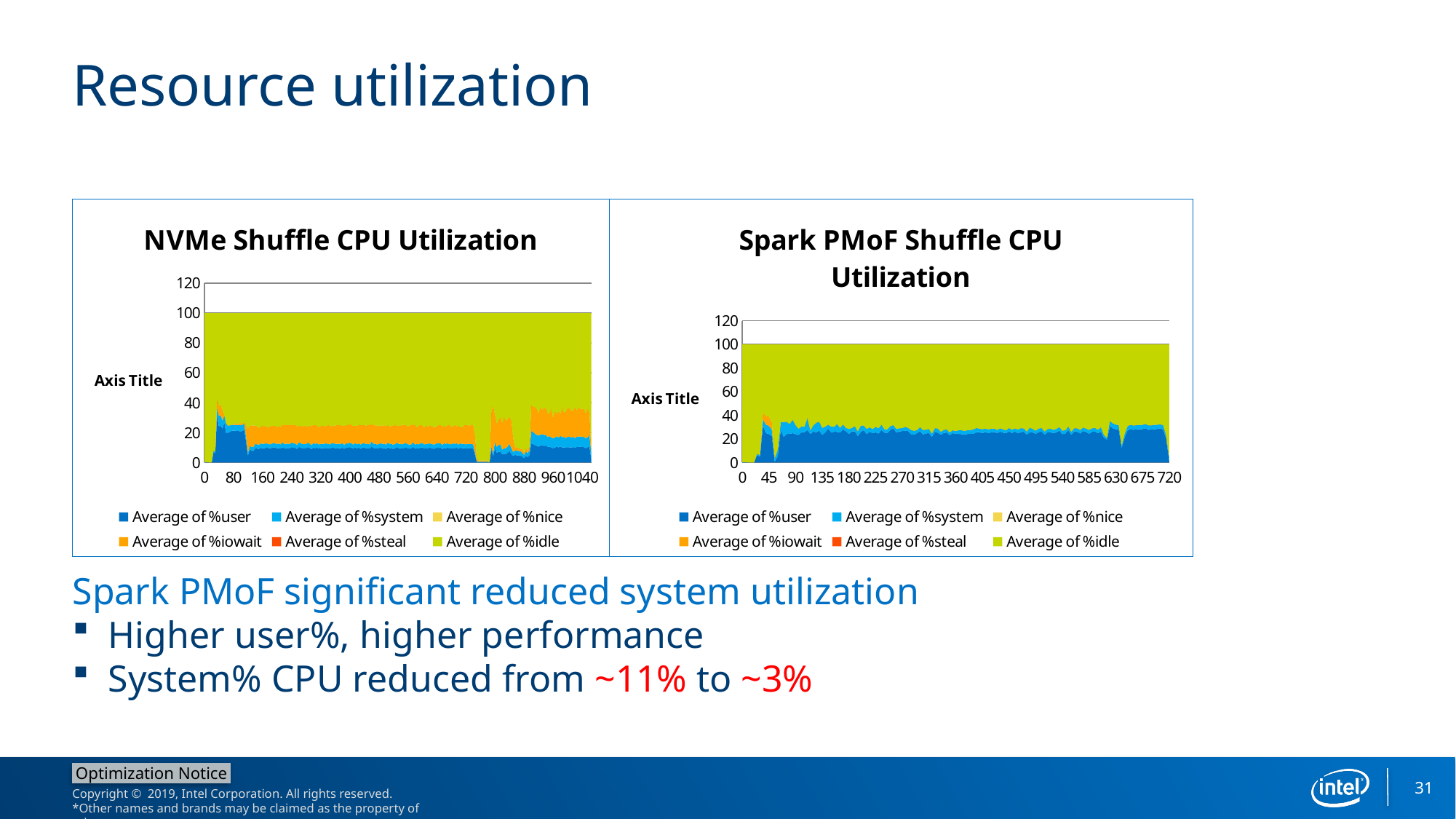
In the Spark PMoF Shuffle CPU Utilization chart, is the Average of %user value at x = 360 greater or less than 40? less In the NVMe Shuffle CPU Utilization chart, which series is drawn in green? Average of %idle How many series does the legend of the NVMe Shuffle CPU Utilization chart list? 6 Which chart shows a larger Average of %iowait area, NVMe Shuffle CPU Utilization or Spark PMoF Shuffle CPU Utilization? NVMe Shuffle CPU Utilization How many series does the legend of the Spark PMoF Shuffle CPU Utilization chart list? 6 In the Spark PMoF Shuffle CPU Utilization chart, which series occupies the largest area? Average of %idle In the Spark PMoF Shuffle CPU Utilization chart, which series occupies the larger area, Average of %user or Average of %iowait? Average of %user In the NVMe Shuffle CPU Utilization chart, is the Average of %idle value at x = 400 greater or less than 60? greater In the NVMe Shuffle CPU Utilization chart, is the Average of %user value at x = 400 greater or less than 20? less What is the title of the chart on the right side of the slide? Spark PMoF Shuffle CPU Utilization What kind of chart is the NVMe Shuffle CPU Utilization chart? stacked area chart